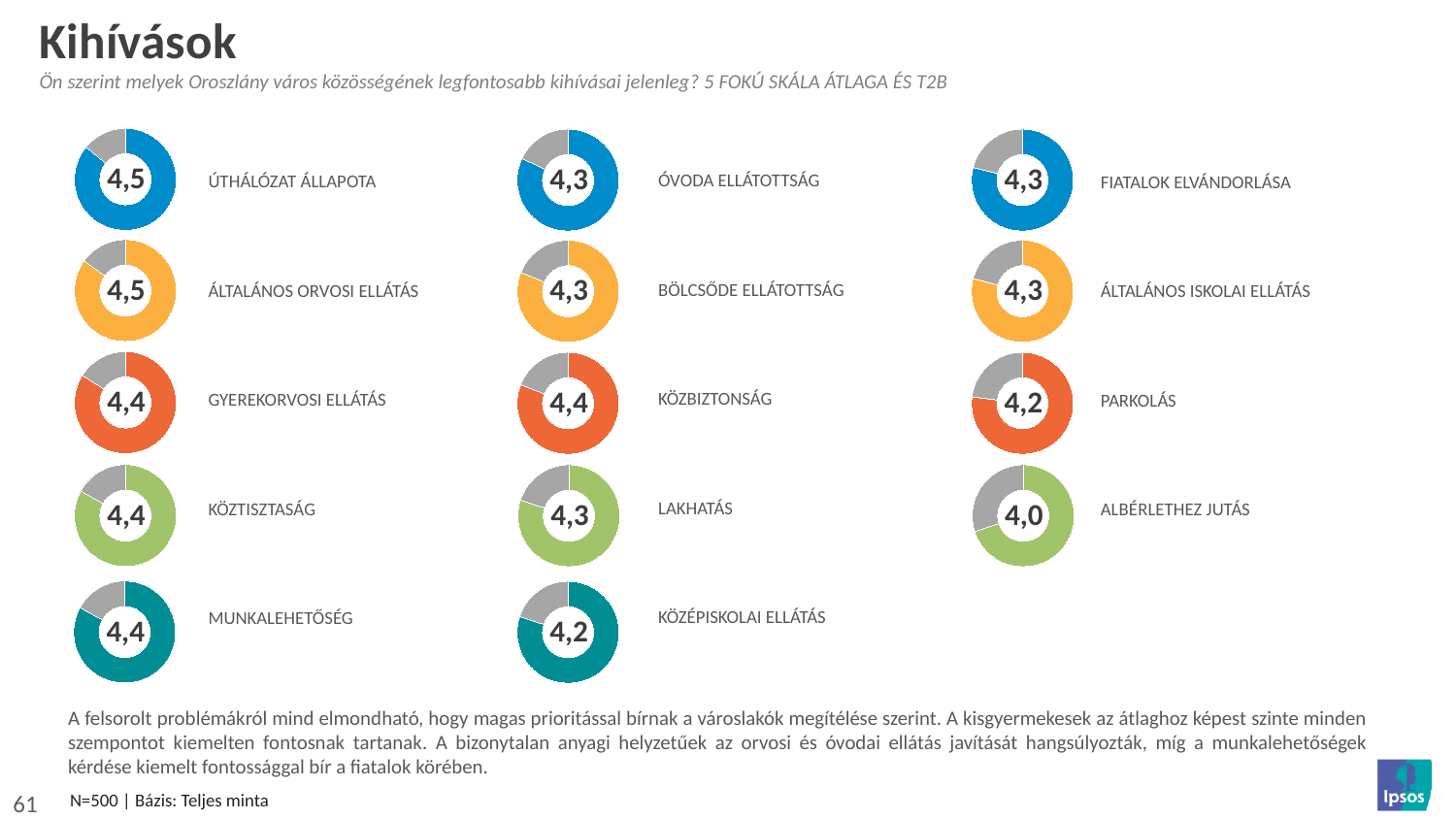
What is the value shown for KÖZBIZTONSÁG? 4,4 What is the value shown for LAKHATÁS? 4,3 What is the value shown for ÚTHÁLÓZAT ÁLLAPOTA? 4,5 What is the value shown for PARKOLÁS? 4,2 What is the difference between the values for ÚTHÁLÓZAT ÁLLAPOTA and ALBÉRLETHEZ JUTÁS? 0,5 What is the value shown for ALBÉRLETHEZ JUTÁS? 4,0 What kind of chart is used to display each value on the slide? Donut (pie) chart Which has a larger value, KÖZÉPISKOLAI ELLÁTÁS or MUNKALEHETŐSÉG? MUNKALEHETŐSÉG What is the title of the slide? Kihívások How many donut charts are shown on the slide? 14 Which two items share the highest value of 4,5? ÚTHÁLÓZAT ÁLLAPOTA and ÁLTALÁNOS ORVOSI ELLÁTÁS Which item has the lowest value on the slide? ALBÉRLETHEZ JUTÁS